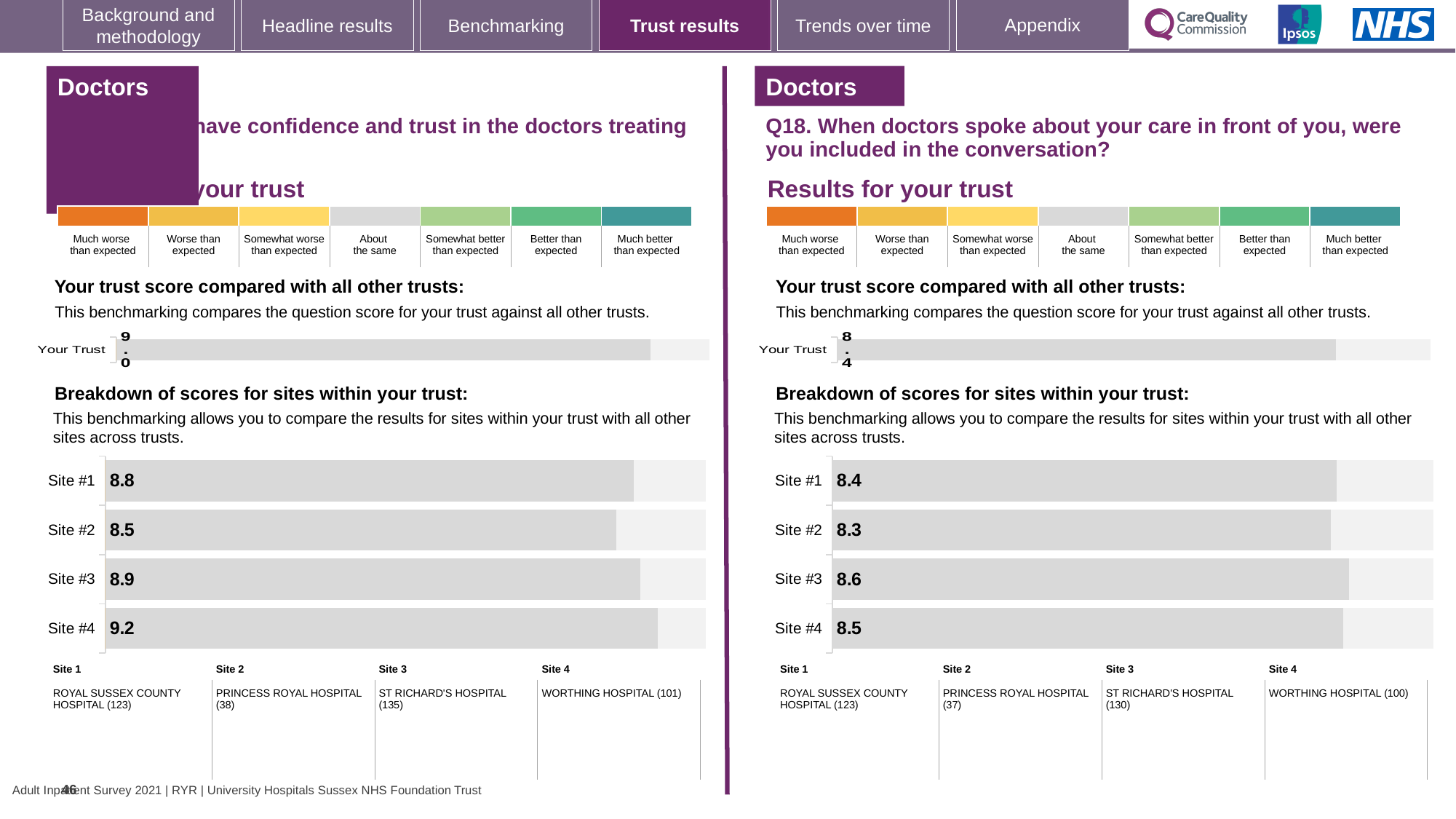
On the Q18 site breakdown chart, which site has the lowest score? Site #2 On the left-hand 'Your trust score compared with all other trusts' chart, what is the score for Your Trust? 9.0 What kind of chart is the Q18 site breakdown chart? Bar chart On the Q18 site breakdown chart, which site has the highest score? Site #3 On the left-hand site breakdown chart, what is the difference between the scores for Site #4 and Site #2? 0.7 On the Q18 site breakdown chart, what is the difference between the scores for Site #3 and Site #2? 0.3 On the Q18 'Your trust score compared with all other trusts' chart, what is the score for Your Trust? 8.4 On the Q18 site breakdown chart, what is the score for Site #3? 8.6 On the left-hand site breakdown chart, which site has the highest score? Site #4 On the left-hand site breakdown chart, what is the score for Site #4? 9.2 On the left-hand site breakdown chart, which site has the lowest score? Site #2 On the Q18 site breakdown chart, how many sites are shown? 4